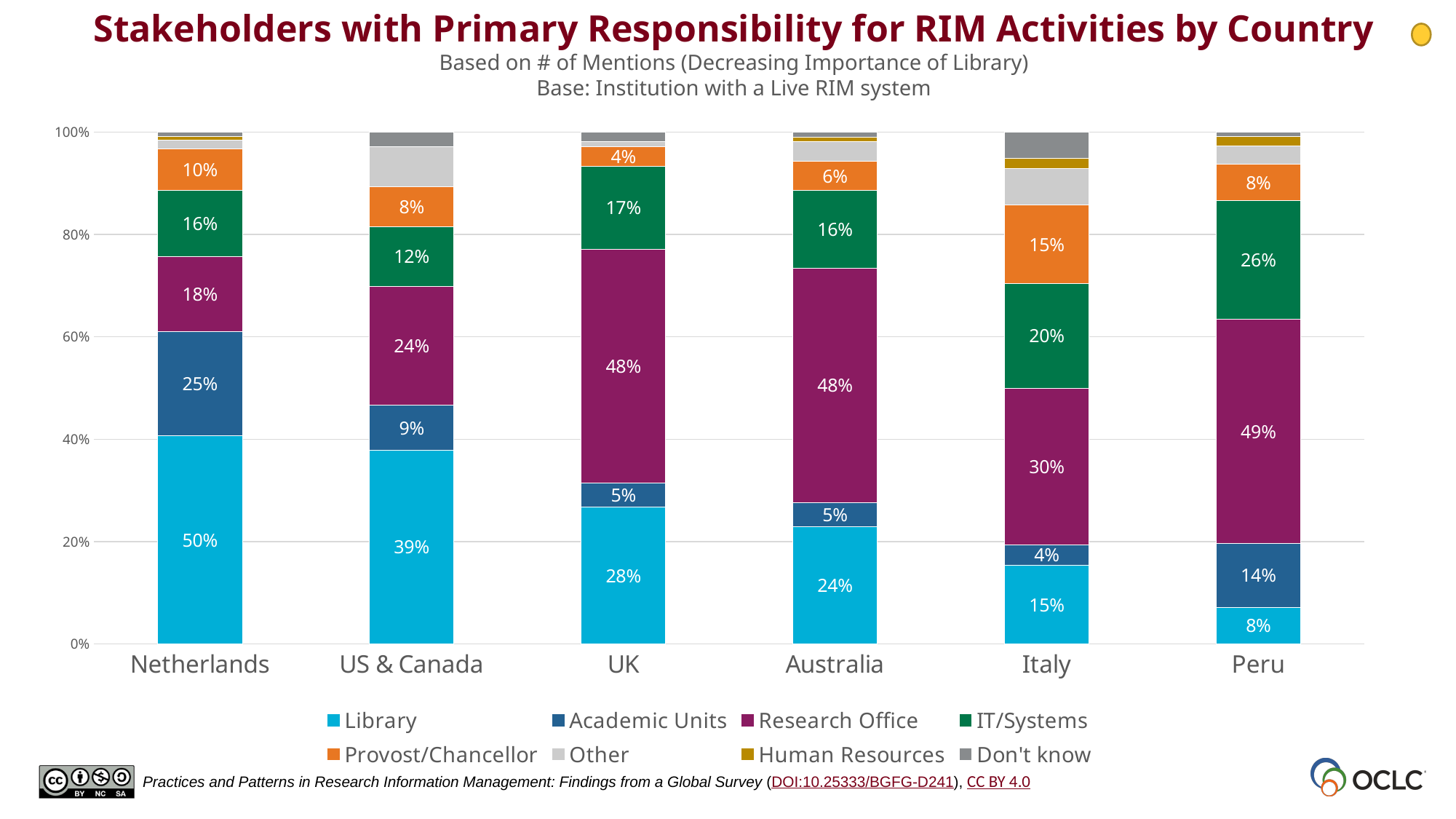
Which country has the lowest Library value? Peru What is the Library value for the Netherlands? 50% What is the IT/Systems value for Italy? 20% Which country has the highest Library value? Netherlands How many series does the legend list? 8 What is the Academic Units value for US & Canada? 9% What is the difference between the Library value for the Netherlands and the Library value for Peru? 42 percentage points What is the Research Office value for Peru? 49% Do the Library values rise or fall moving from left to right across the countries? Fall How many countries/regions are shown on the x axis? 6 Which is larger: the Research Office value for Italy or the Research Office value for the UK? UK What type of chart is shown on the slide? Stacked bar chart